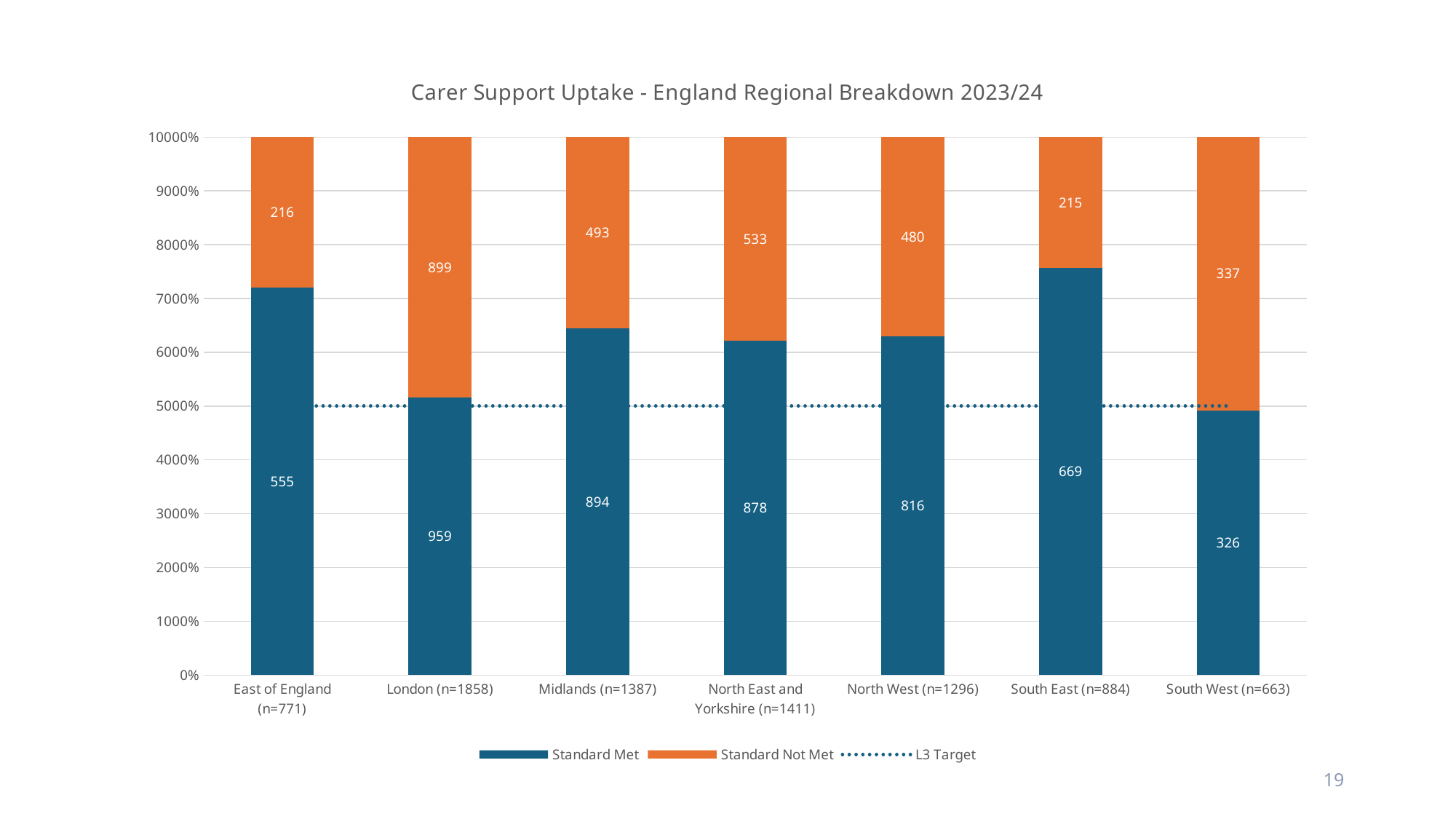
Which region has the lowest Standard Not Met value? South East (n=884) What is the Standard Met value for South West (n=663)? 326 What is the total of the Standard Met and Standard Not Met values for East of England (n=771)? 771 What is the Standard Not Met value for North East and Yorkshire (n=1411)? 533 How many regions are shown on the x axis? 7 What is the difference between the Standard Met and Standard Not Met values for Midlands (n=1387)? 401 What is the Standard Met value for London (n=1858)? 959 Which is larger for North West (n=1296): the Standard Met value or the Standard Not Met value? Standard Met How many entries does the legend list? 3 What is the title of the chart? Carer Support Uptake - England Regional Breakdown 2023/24 What kind of chart is this? Stacked bar chart